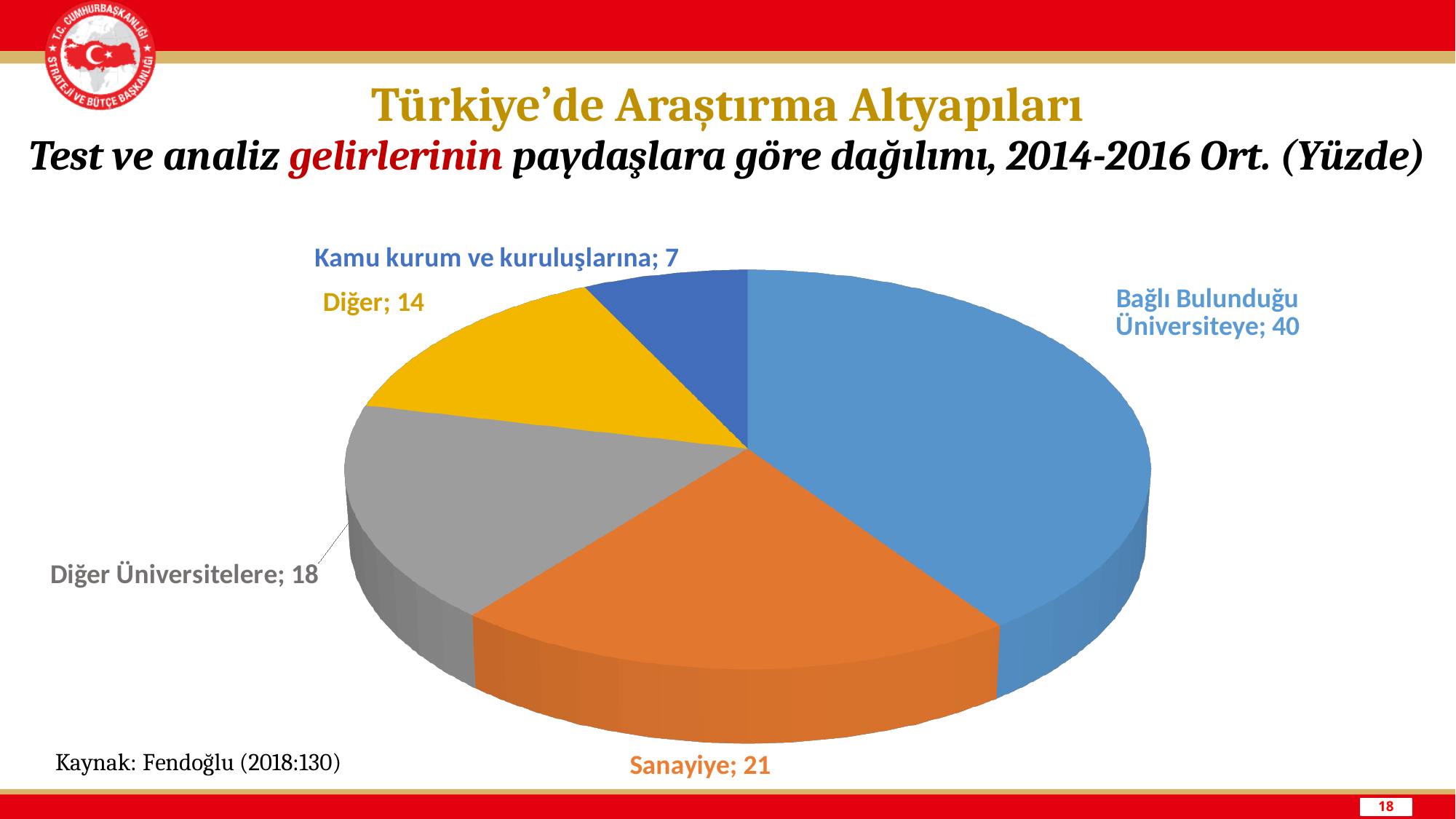
What share of the pie does Sanayiye represent? 21% What colour is the Sanayiye slice? Orange What is the value for Sanayiye? 21 What is the difference between the values for Bağlı Bulunduğu Üniversiteye and Sanayiye? 19 Which is larger, the value for Diğer Üniversitelere or the value for Diğer? Diğer Üniversitelere What is the value for Diğer Üniversitelere? 18 What is the value for Bağlı Bulunduğu Üniversiteye? 40 What is the value for Kamu kurum ve kuruluşlarına? 7 Which category has the largest slice of the pie? Bağlı Bulunduğu Üniversiteye Which category has the smallest slice of the pie? Kamu kurum ve kuruluşlarına How many slices does the pie chart have? 5 What kind of chart is shown on the slide? Pie chart